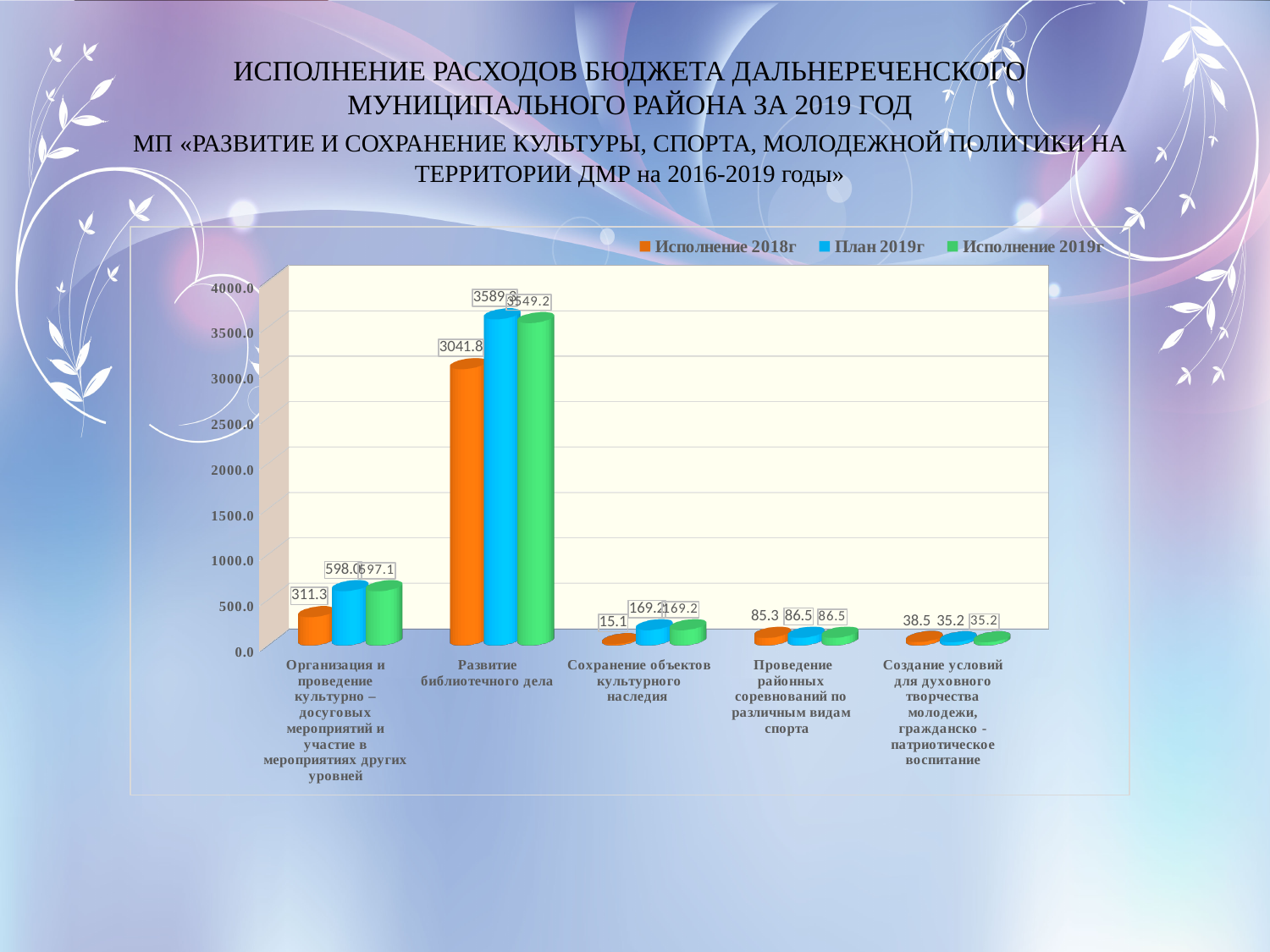
What is the value of Исполнение 2019г for Сохранение объектов культурного наследия? 169.2 How many categories are shown on the x axis? 5 What is the value of Исполнение 2019г for Организация и проведение культурно – досуговых мероприятий и участие в мероприятиях других уровней? 597.1 For Создание условий для духовного творчества молодежи, гражданско-патриотическое воспитание, which is larger: Исполнение 2018г or Исполнение 2019г? Исполнение 2018г Which colour represents План 2019г in the legend? blue How many series does the legend list? 3 What is the value of Исполнение 2018г for Развитие библиотечного дела? 3041.8 What is the value of Исполнение 2018г for Сохранение объектов культурного наследия? 15.1 What kind of chart is shown on the slide? bar chart Which category has the highest value for Исполнение 2019г? Развитие библиотечного дела What is the difference between Исполнение 2019г and Исполнение 2018г for Проведение районных соревнований по различным видам спорта? 1.2 Which category has the lowest value for Исполнение 2018г? Сохранение объектов культурного наследия